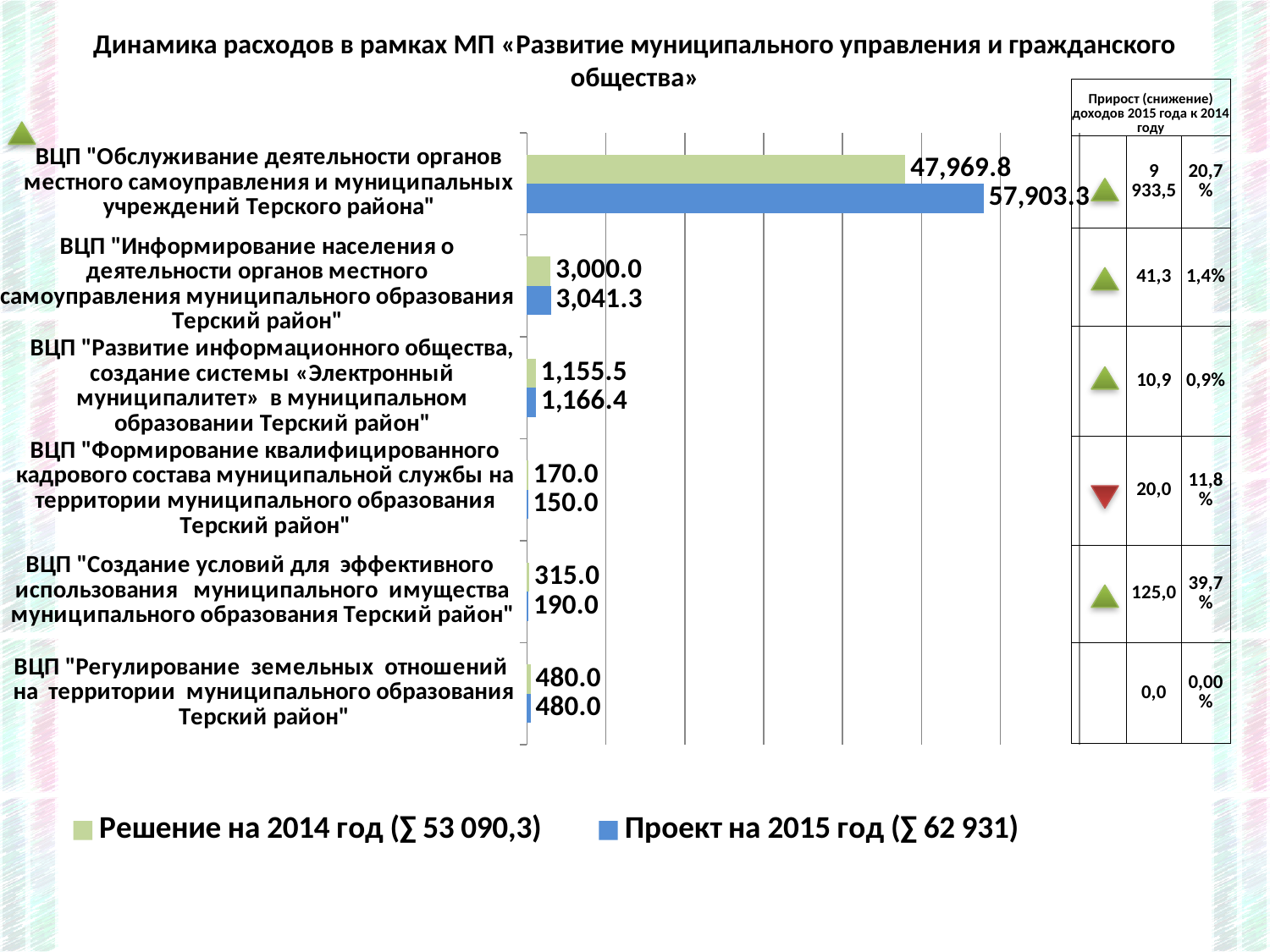
What is the difference between the 2014 and 2015 values for ВЦП "Создание условий для эффективного использования муниципального имущества муниципального образования Терский район"? 125.0 How many series does the legend list? 2 What is the difference between the 2015 and 2014 values for ВЦП "Обслуживание деятельности органов местного самоуправления и муниципальных учреждений Терского района"? 9,933.5 How many categories (ВЦП programmes) are plotted in the chart? 6 Which category has the highest value for "Проект на 2015 год"? ВЦП "Обслуживание деятельности органов местного самоуправления и муниципальных учреждений Терского района" What is the value of "Решение на 2014 год" for ВЦП "Информирование населения о деятельности органов местного самоуправления муниципального образования Терский район"? 3,000.0 What is the value of "Проект на 2015 год" for ВЦП "Обслуживание деятельности органов местного самоуправления и муниципальных учреждений Терского района"? 57,903.3 What total sum is shown in the legend for "Проект на 2015 год"? ∑ 62 931 Which category has the lowest value for "Решение на 2014 год"? ВЦП "Формирование квалифицированного кадрового состава муниципальной службы на территории муниципального образования Терский район" What is the value of "Проект на 2015 год" for ВЦП "Формирование квалифицированного кадрового состава муниципальной службы на территории муниципального образования Терский район"? 150.0 For ВЦП "Создание условий для эффективного использования муниципального имущества муниципального образования Терский район", which is larger: the 2014 value or the 2015 value? The 2014 value (315.0) What type of chart is shown on the slide? Bar chart